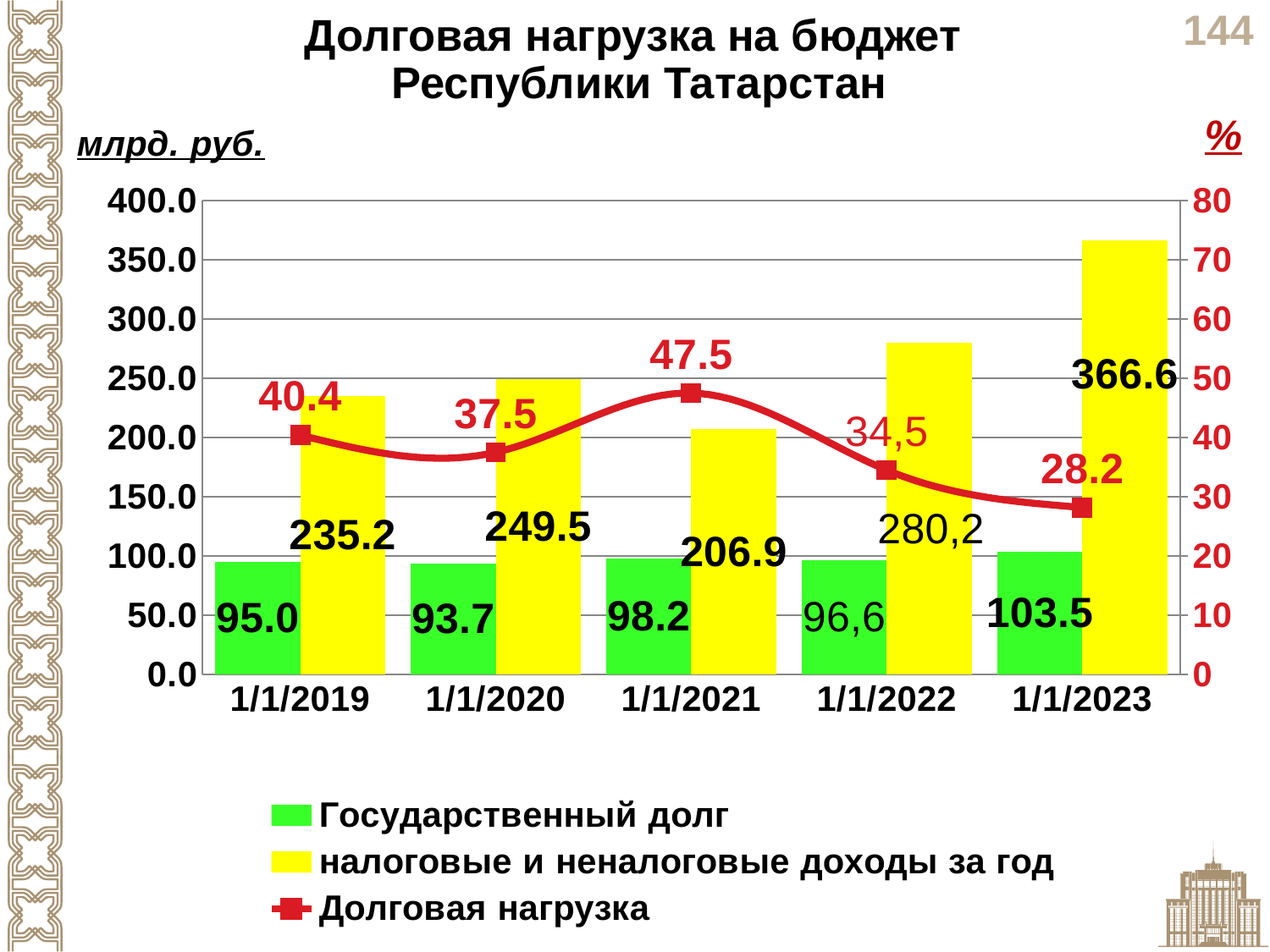
What is the value of налоговые и неналоговые доходы за год on 1/1/2023? 366.6 What is the Долговая нагрузка value on 1/1/2021? 47.5 On which date is Долговая нагрузка the highest? 1/1/2021 How many dates are shown on the x axis? 5 On which date is Государственный долг the highest? 1/1/2023 How many series does the legend list? 3 What is the value of Государственный долг on 1/1/2019? 95.0 Does Долговая нагрузка rise or fall from 1/1/2021 to 1/1/2023? fall Which is larger: налоговые и неналоговые доходы за год on 1/1/2020 or on 1/1/2021? 1/1/2020 What is the difference between налоговые и неналоговые доходы за год on 1/1/2023 and on 1/1/2022? 86.4 What is the value of налоговые и неналоговые доходы за год on 1/1/2022? 280,2 On which date is Долговая нагрузка the lowest? 1/1/2023